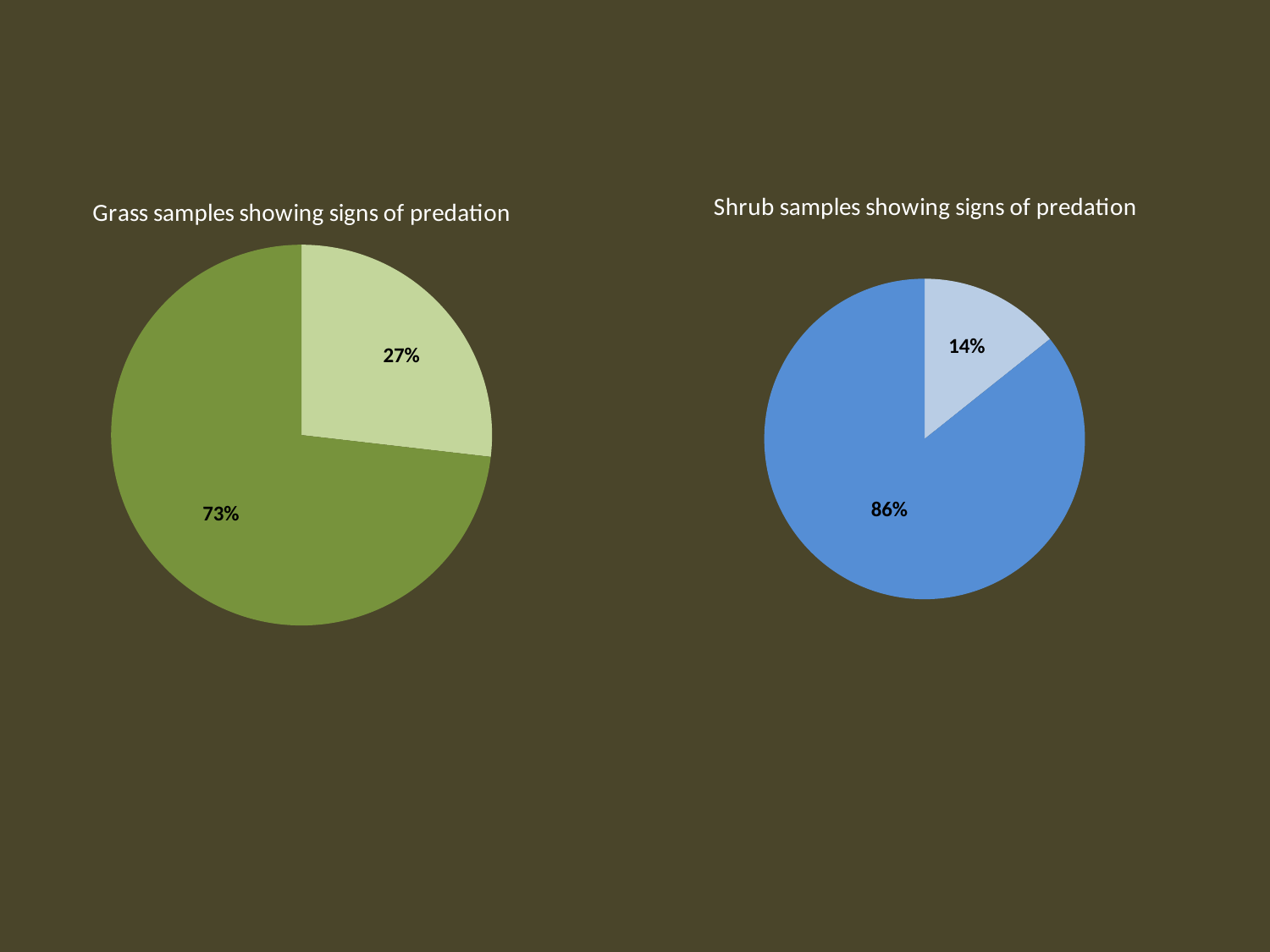
In the "Shrub samples showing signs of predation" chart, what percentage is shown on the larger, blue slice? 86% In the "Shrub samples showing signs of predation" chart, what percentage is shown on the smaller, light blue slice? 14% How many slices does the "Grass samples showing signs of predation" pie chart have? 2 What kind of chart is the "Shrub samples showing signs of predation" chart? pie chart In the "Grass samples showing signs of predation" chart, what percentage is shown on the larger slice? 73% In the "Grass samples showing signs of predation" chart, what percentage is shown on the smaller, light green slice? 27% What kind of chart is the "Grass samples showing signs of predation" chart? pie chart What is the title of the pie chart on the right side of the slide? Shrub samples showing signs of predation How many slices does the "Shrub samples showing signs of predation" pie chart have? 2 Which chart has the larger smallest slice: the "Grass samples showing signs of predation" chart or the "Shrub samples showing signs of predation" chart? Grass samples showing signs of predation In the "Shrub samples showing signs of predation" chart, what is the difference in percentage points between the larger and smaller slices? 72 In the "Grass samples showing signs of predation" chart, what is the difference in percentage points between the larger and smaller slices? 46